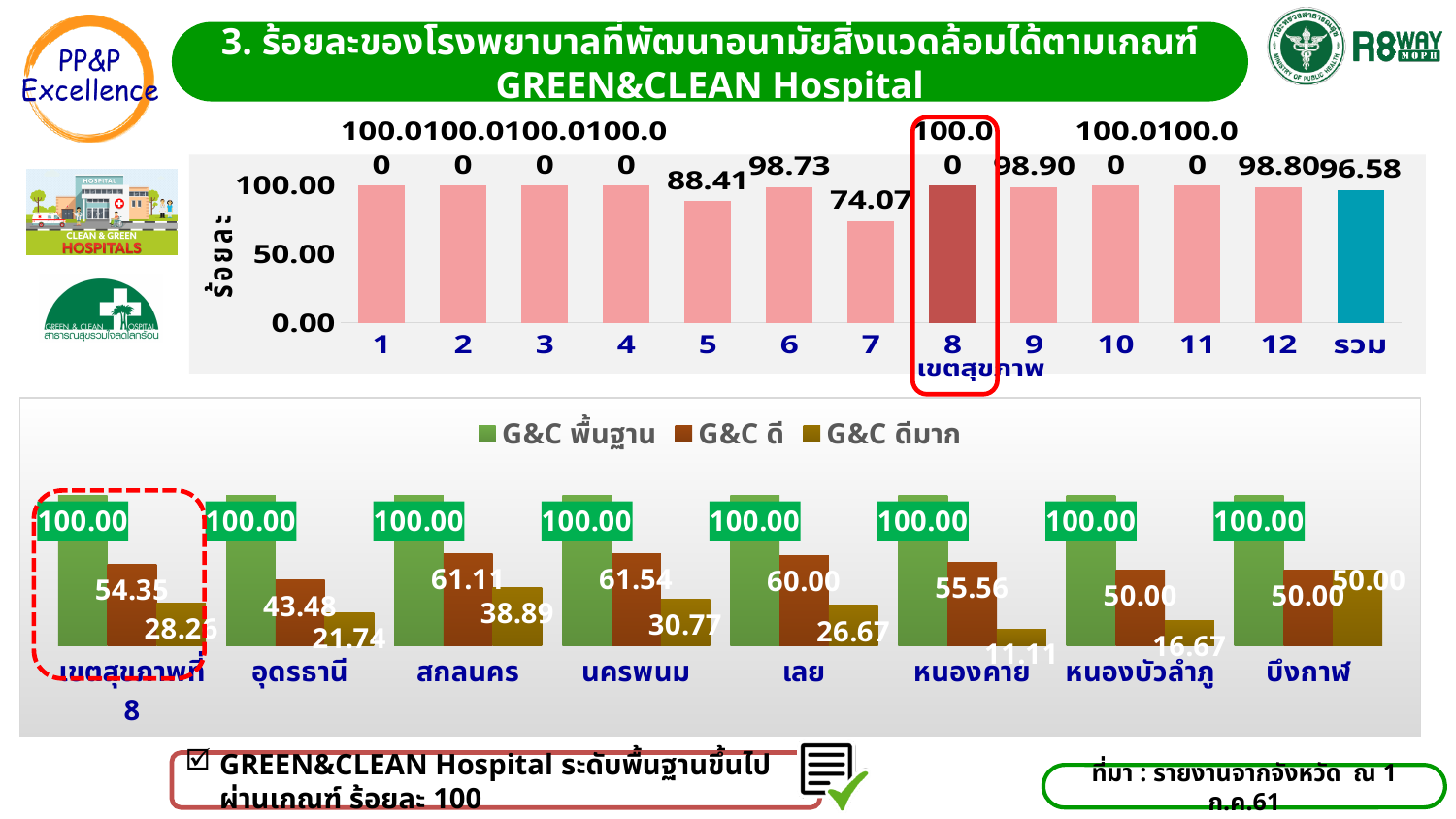
In the bottom chart, what is the G&C ดีมาก value for หนองคาย? 11.11 In the top chart, what is the value for category 5? 88.41 How many series does the legend of the bottom chart list? 3 In the bottom chart, what is the G&C ดี value for นครพนม? 61.54 In the top chart, what is the value for category 7? 74.07 In the top chart, what is the value for รวม? 96.58 In the top chart, how many bars are plotted? 13 In the bottom chart, which is larger: the G&C ดี value for สกลนคร or for อุดรธานี? สกลนคร In the top chart, is the value for category 7 greater or less than 50.00? greater In the top chart, what is the difference between the values for category 6 and category 7? 24.66 In the bottom chart, which category has the highest G&C ดีมาก value? บึงกาฬ In the top chart, which category has the lowest value? 7